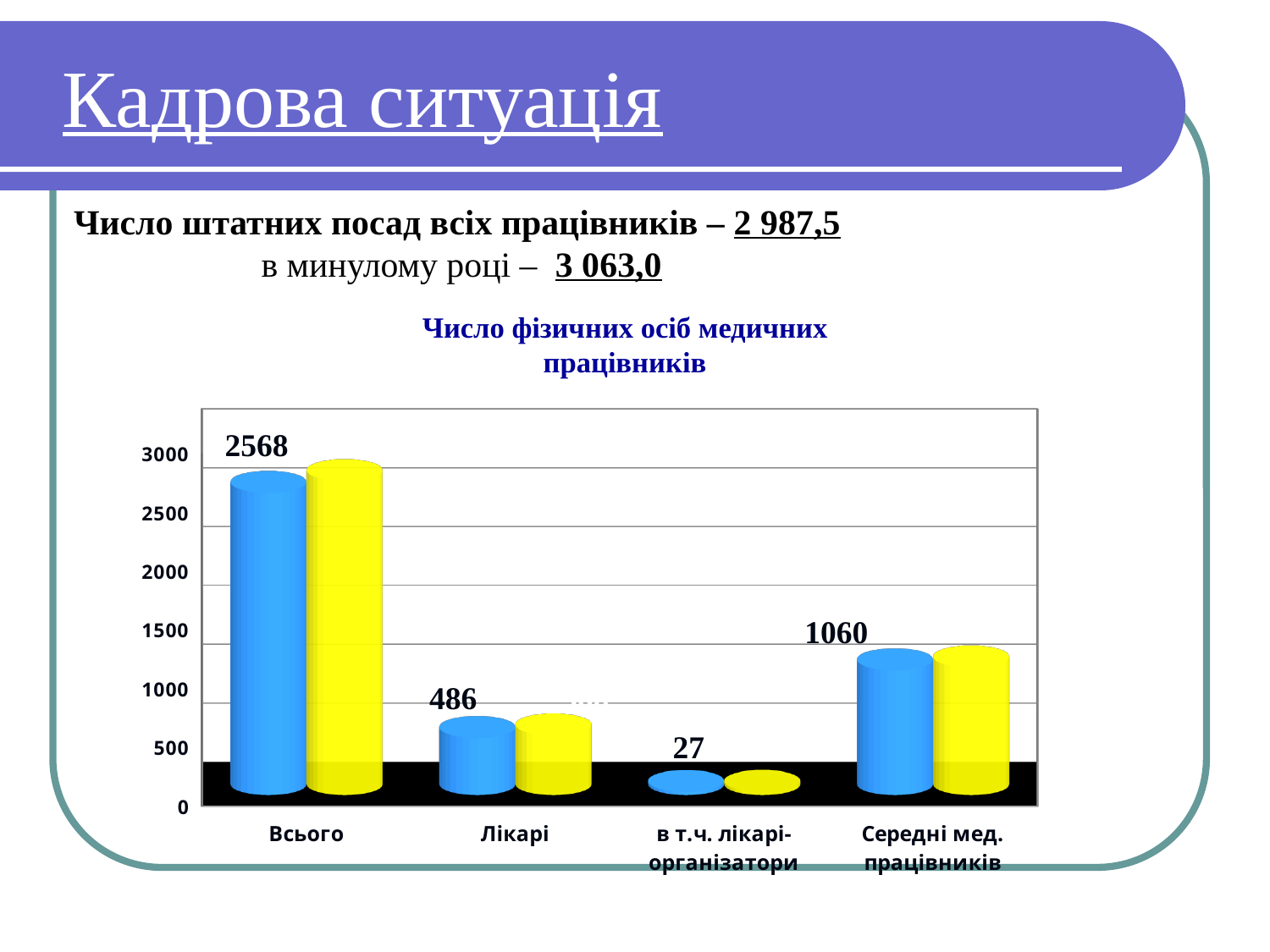
What kind of chart is shown on the slide? bar chart What is the labelled value for Лікарі? 486 How many categories are shown on the x axis? 4 What is the labelled value for Середні мед. працівників? 1060 What is the labelled value for Всього? 2568 Which is larger, the labelled value for Лікарі or for Середні мед. працівників? Середні мед. працівників Is the value of the yellow bar for Всього greater or less than 2500? greater Which category has the highest labelled value? Всього Which category has the lowest labelled value? в т.ч. лікарі-організатори What is the difference between the labelled values for Всього and Лікарі? 2082 What is the labelled value for в т.ч. лікарі-організатори? 27 What is the difference between the labelled values for Середні мед. працівників and Лікарі? 574